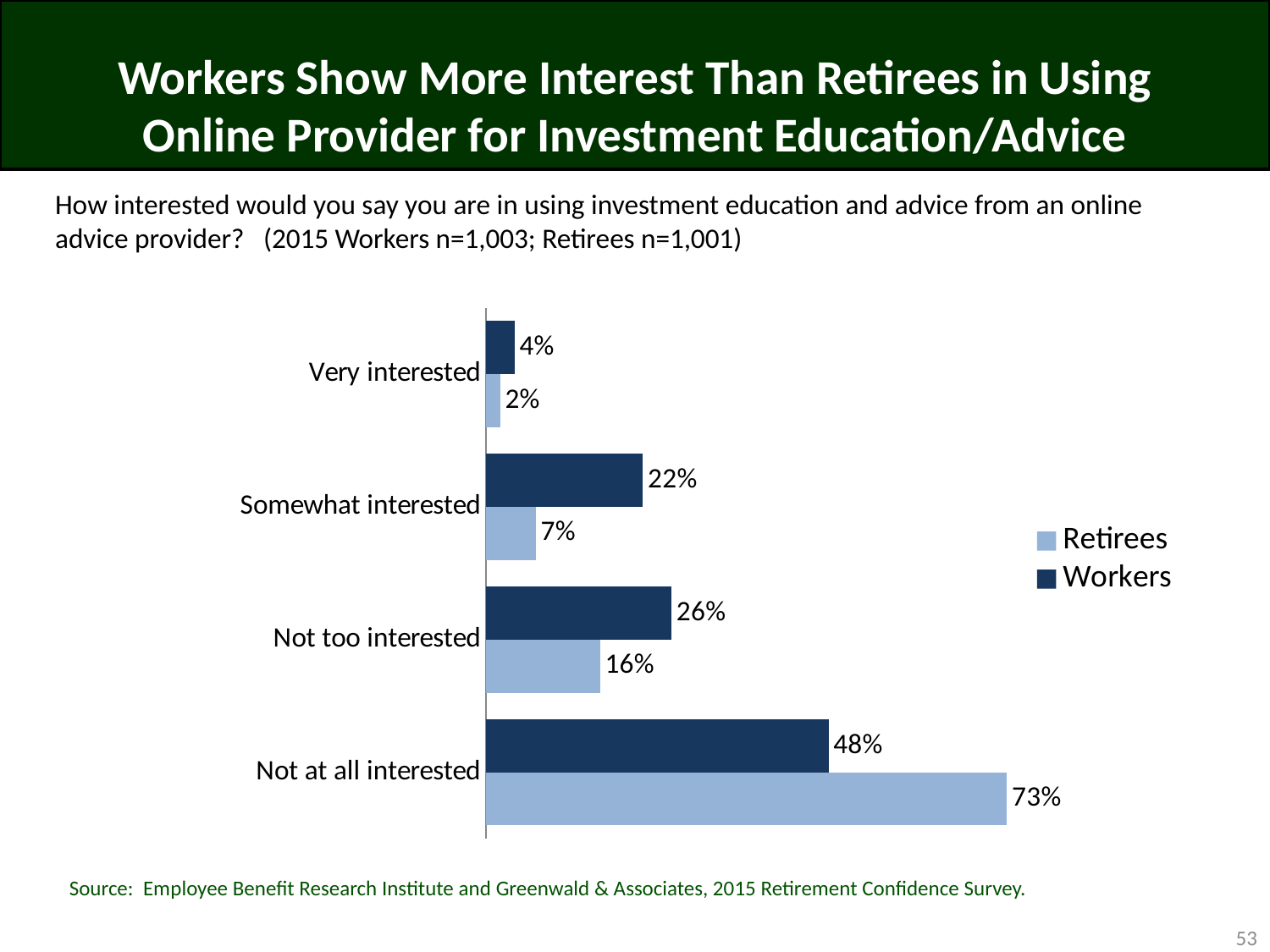
What percentage of Workers are "Very interested"? 4% Which category has the lowest value for Workers? Very interested What is the difference between Retirees and Workers for "Not at all interested"? 25% What percentage of Workers are "Not too interested"? 26% How many series does the legend list? 2 Which category has the highest value for Retirees? Not at all interested What kind of chart is shown on the slide? Bar chart What percentage of Retirees are "Somewhat interested"? 7% How many response categories are shown on the chart? 4 What percentage of Retirees are "Not at all interested"? 73% For "Not too interested", which group has the larger value, Workers or Retirees? Workers What is the difference between Workers and Retirees for "Somewhat interested"? 15%